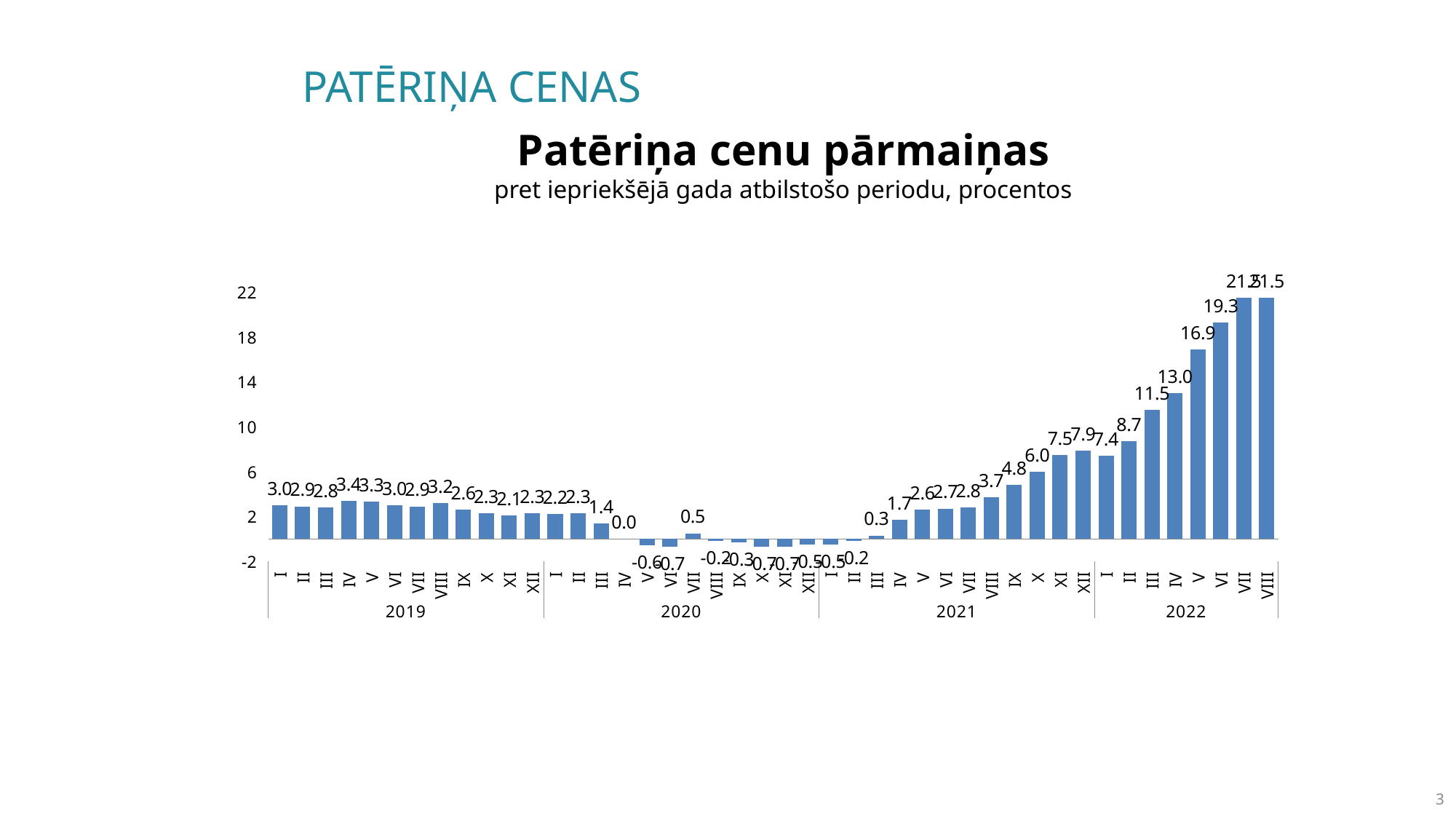
Do the values rise or fall across the months of 2022 from I to VIII? rise Which is larger, the value for XII 2021 or the value for I 2022? XII 2021 What is the difference between the values for IV 2022 and III 2022? 1.5 What is the value for III 2020? 1.4 What is the value for VIII 2022? 21.5 What is the difference between the values for VI 2022 and V 2022? 2.4 How many bars are plotted in the chart? 44 What is the value for IV 2019? 3.4 What is the value for V 2022? 16.9 What kind of chart is shown on the slide? bar chart What is the value for X 2021? 6.0 Is the value for VI 2022 greater or less than 18? greater